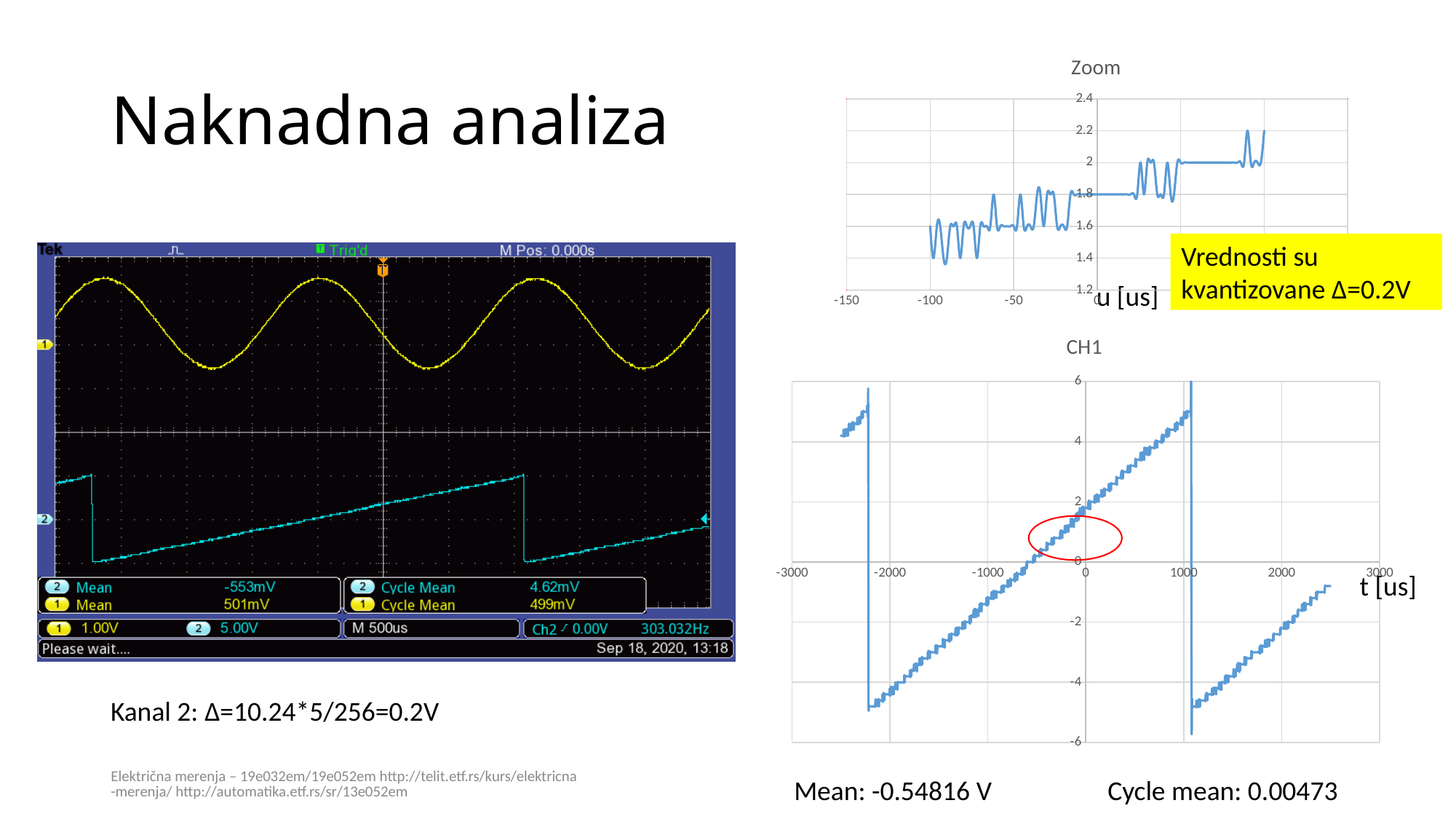
In the CH1 chart, is the value at t = 500 greater or less than 2? greater In the Zoom chart, is the value at t = -100 greater or less than 1.8? less What is the title of the chart in the top right of the slide? Zoom What is the title of the chart in the bottom right of the slide? CH1 In the CH1 chart, what is the highest tick value shown on the vertical axis? 6 In the Zoom chart, what is the highest tick value shown on the vertical axis? 2.4 What kind of chart is the CH1 chart? line chart In the CH1 chart, is the value at t = 2000 greater or less than 0? less In the Zoom chart, what is the lowest tick value shown on the vertical axis? 1.2 In the CH1 chart, do the values rise or fall along the x axis between t = -2000 and t = 1000? rise What kind of chart is the Zoom chart? line chart In the CH1 chart, what is the lowest tick value shown on the vertical axis? -6